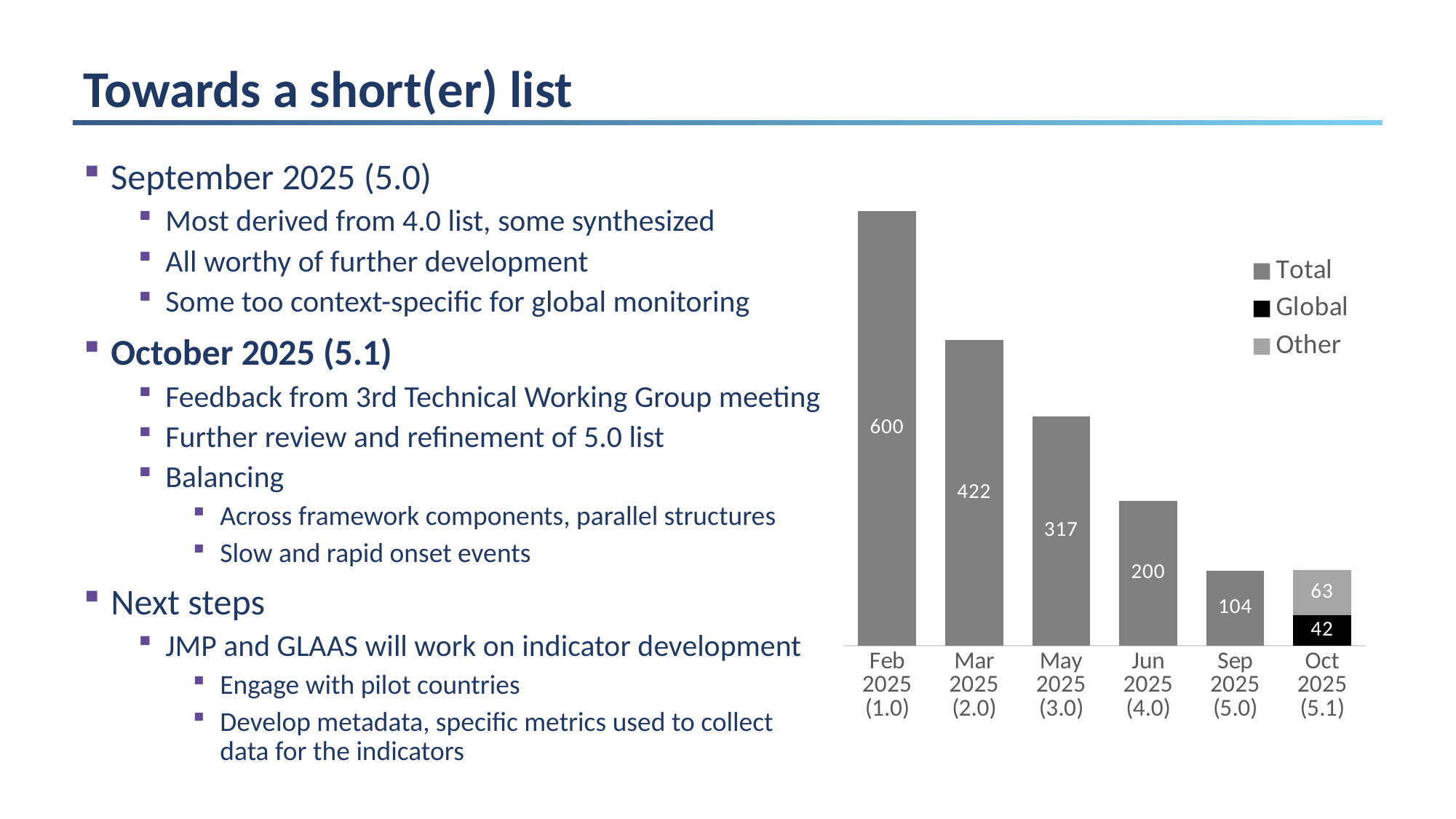
Which is larger, the Total value for Sep 2025 (5.0) or the Other value for Oct 2025 (5.1)? Sep 2025 (5.0) What is the Total value for Feb 2025 (1.0)? 600 What is the difference between the Total values for May 2025 (3.0) and Jun 2025 (4.0)? 117 How many categories are shown on the x axis? 6 What is the difference between the Total values for Feb 2025 (1.0) and Mar 2025 (2.0)? 178 Which category has the highest Total value? Feb 2025 (1.0) What is the combined height of the stacked bar for Oct 2025 (5.1)? 105 How many series does the legend list? 3 What is the Global value for Oct 2025 (5.1)? 42 What is the Total value for Jun 2025 (4.0)? 200 What is the Total value for Mar 2025 (2.0)? 422 What is the Other value for Oct 2025 (5.1)? 63